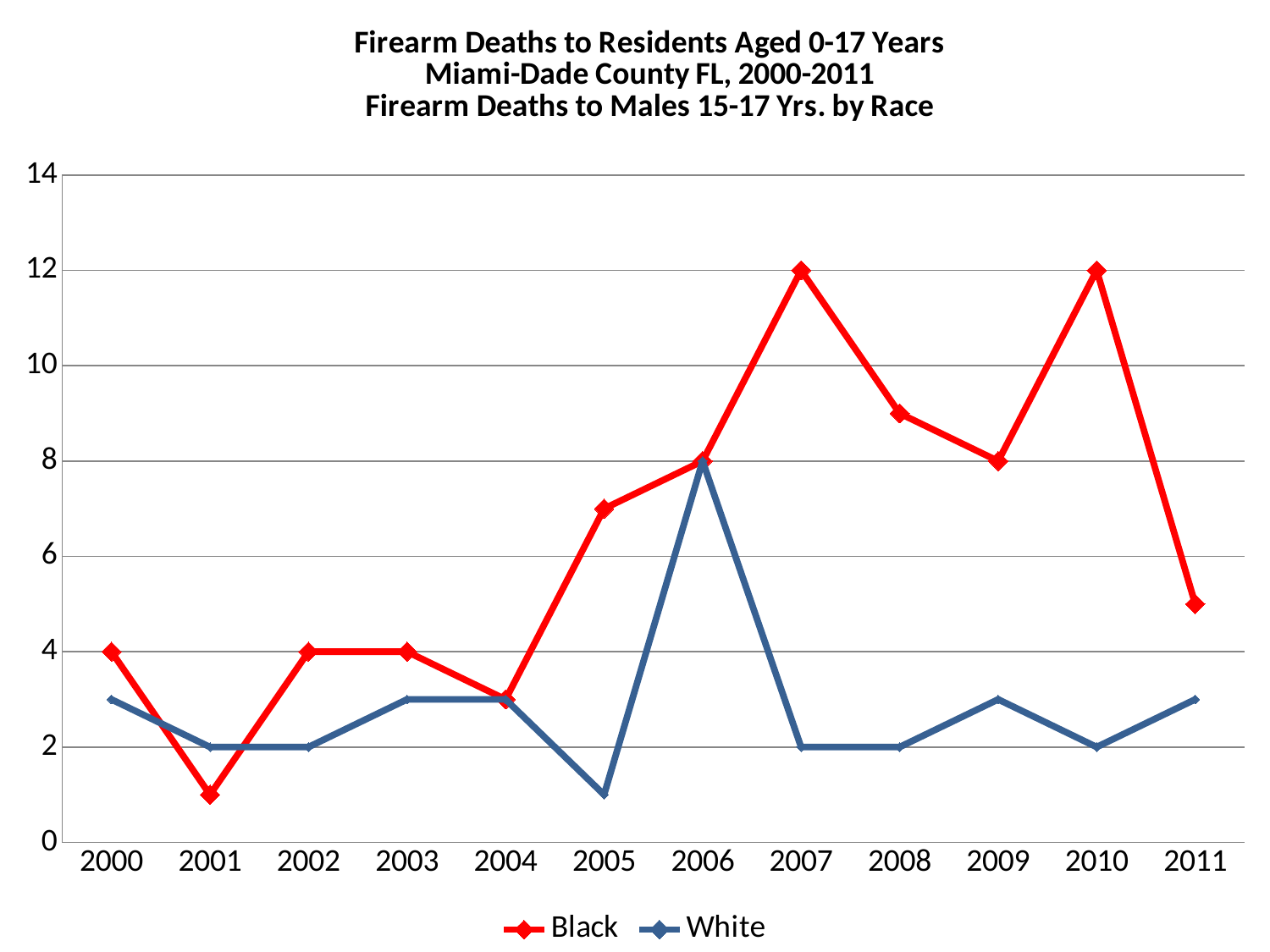
In which year is the White series at its highest? 2006 Which series has the larger value in 2010, Black or White? Black What is the value for Black in 2007? 12 What type of chart is shown on the slide? Line chart What is the value for White in 2006? 8 Is the value for Black in 2005 greater or less than 6? greater What is the value for Black in 2000? 4 How many years are plotted along the x axis? 12 In which year is the Black series at its lowest? 2001 How many series does the legend list? 2 Does the Black series rise or fall from 2004 to 2007? Rise What is the difference between the Black and White values in 2007? 10